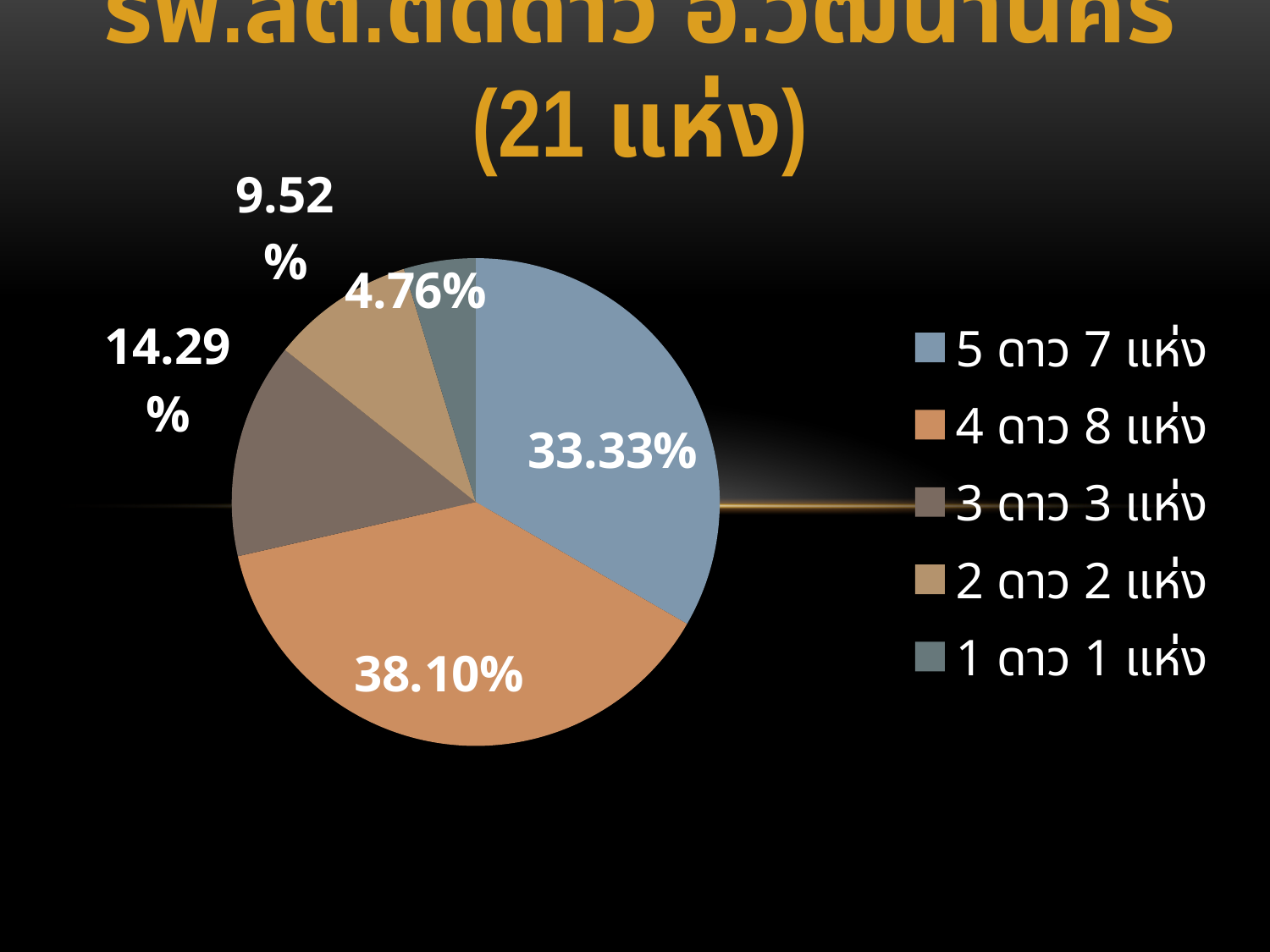
Which slice is larger: "5 ดาว 7 แห่ง" or "3 ดาว 3 แห่ง"? 5 ดาว 7 แห่ง What is the difference in percentage points between the "4 ดาว 8 แห่ง" slice and the "5 ดาว 7 แห่ง" slice? 4.77 What percentage share is shown for the "4 ดาว 8 แห่ง" slice? 38.10% What percentage share is shown for the "5 ดาว 7 แห่ง" slice? 33.33% What percentage share is shown for the "2 ดาว 2 แห่ง" slice? 9.52% What percentage share is shown for the "1 ดาว 1 แห่ง" slice? 4.76% What percentage share is shown for the "3 ดาว 3 แห่ง" slice? 14.29% What kind of chart is shown on the slide? pie chart How many entries does the legend list? 5 How many slices does the pie chart have? 5 Which category has the smallest slice of the pie? 1 ดาว 1 แห่ง Which category has the largest slice of the pie? 4 ดาว 8 แห่ง